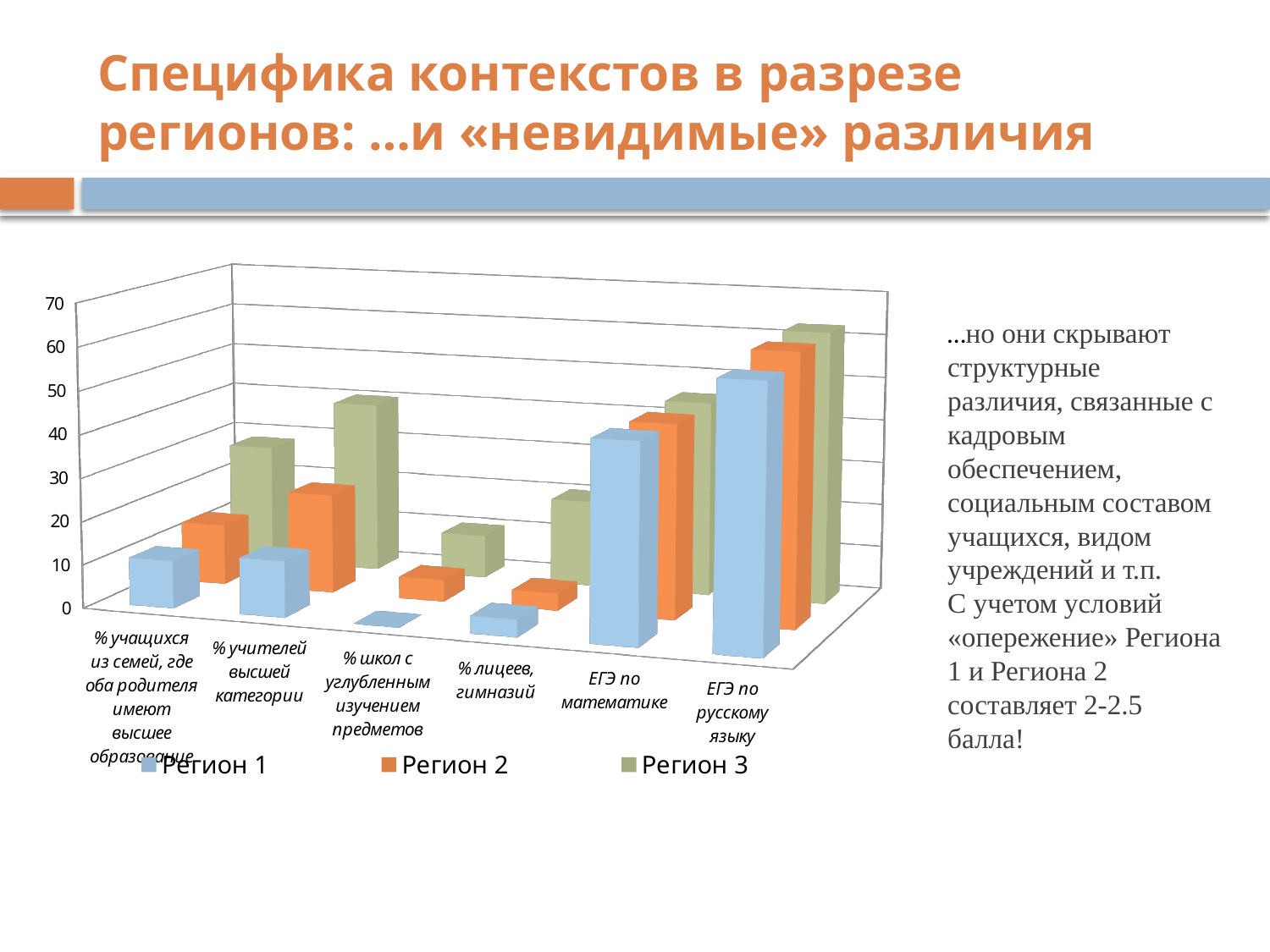
How many categories are shown along the x axis of the chart? 6 What kind of chart is shown on the slide? Bar chart Which region has the highest value for '% учителей высшей категории'? Регион 3 How many series does the chart legend list? 3 Is the value of Регион 3 for '% учителей высшей категории' greater or less than 30? greater For which category does Регион 3 reach its highest value? ЕГЭ по русскому языку Is the value of Регион 1 for 'ЕГЭ по математике' greater or less than 20? greater For '% учащихся из семей, где оба родителя имеют высшее образование', which is larger: Регион 1 or Регион 3? Регион 3 Is the value of Регион 1 for '% школ с углубленным изучением предметов' greater or less than 10? less Which region has the lowest value for 'ЕГЭ по русскому языку'? Регион 1 Which series is shown in orange in the chart? Регион 2